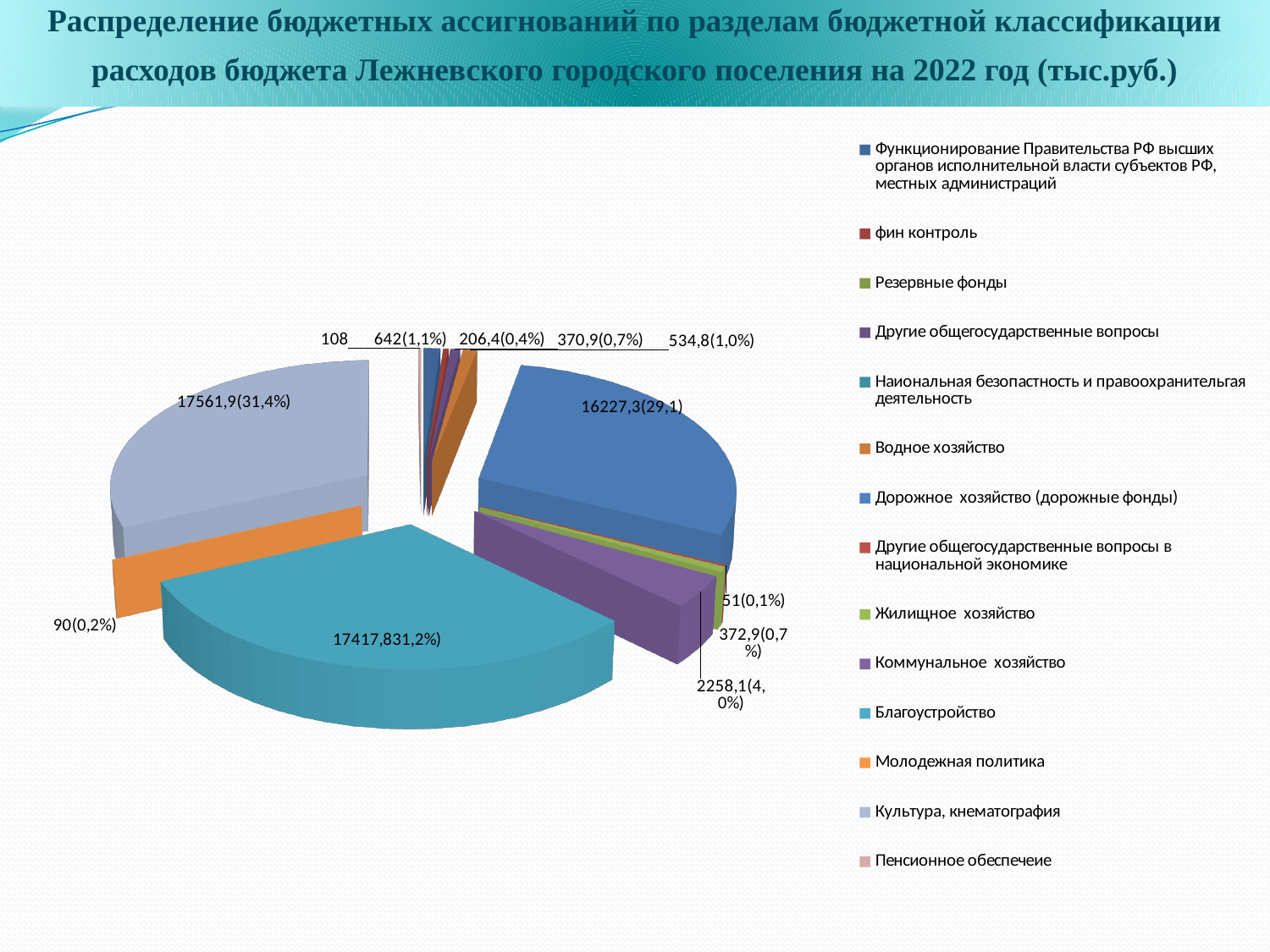
What share of the pie does the Культура, кнематография slice represent? 31,4% What year does the chart title say the budget allocations are for? 2022 What is the difference between the Культура, кнематография value and the Дорожное хозяйство (дорожные фонды) value? 1334,6 What value is shown for the Коммунальное хозяйство slice? 2258,1 Which is larger, the Благоустройство slice or the Дорожное хозяйство (дорожные фонды) slice? Благоустройство What kind of chart is shown on the slide? pie chart What share of the pie does the Коммунальное хозяйство slice represent? 4,0% What share of the pie does the Дорожное хозяйство (дорожные фонды) slice represent? 29,1 Which category has the largest slice of the pie? Культура, кнематография What value is shown for the Дорожное хозяйство (дорожные фонды) slice? 16227,3 What value is shown for the Культура, кнематография slice? 17561,9 How many categories does the legend of the pie chart list? 14